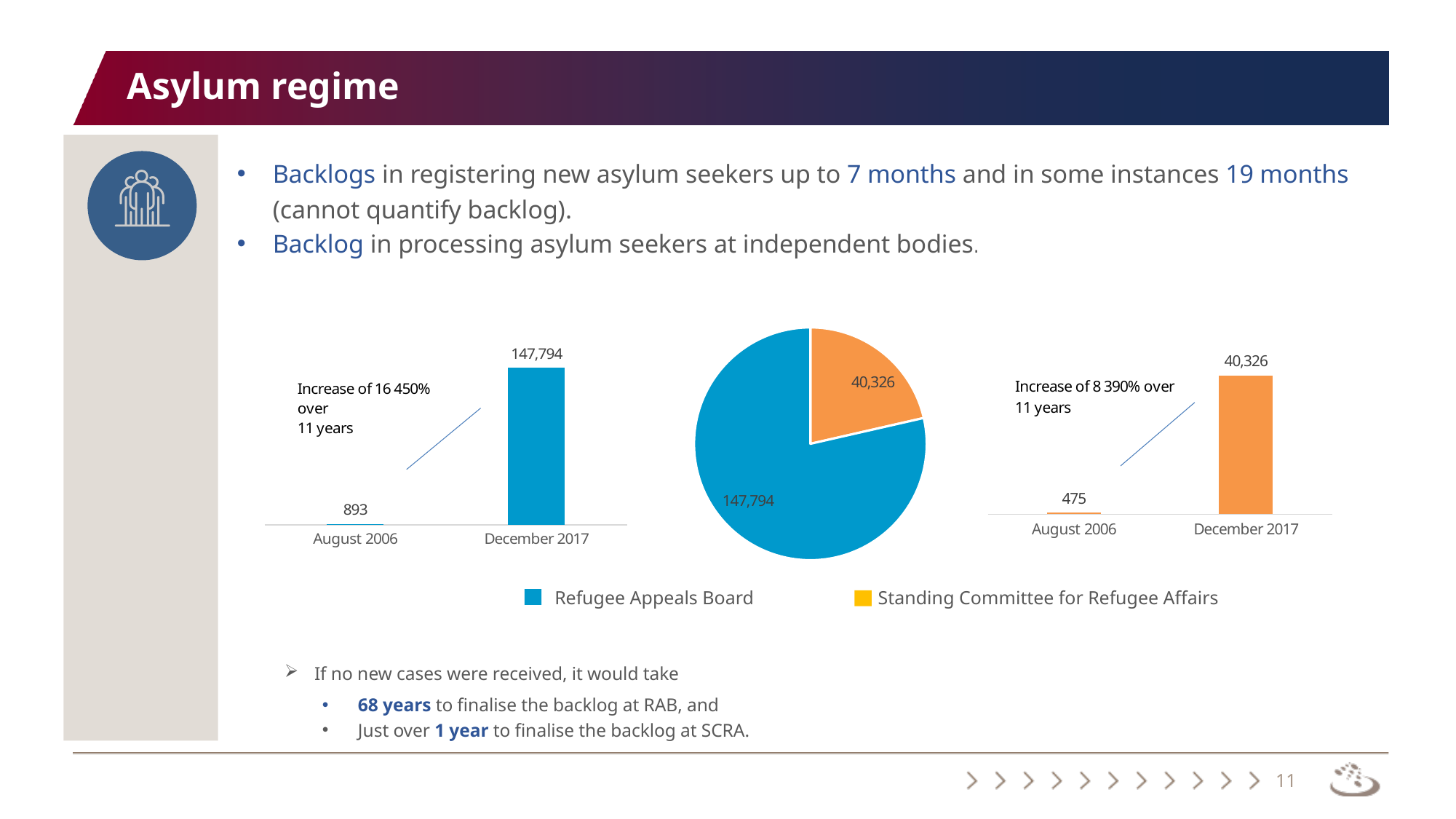
In the left bar chart, what is the difference between the December 2017 and August 2006 values? 146,901 In the middle pie chart, which slice is larger: Refugee Appeals Board or Standing Committee for Refugee Affairs? Refugee Appeals Board How many categories are shown on the x axis of the left bar chart? 2 In the right bar chart, what is the difference between the December 2017 and August 2006 values? 39,851 How many series does the legend below the charts list? 2 What is the total of the two slices in the middle pie chart? 188,120 In the right bar chart, what is the value for December 2017? 40,326 In the right bar chart, what is the value for August 2006? 475 In the middle pie chart, what is the value of the Standing Committee for Refugee Affairs slice? 40,326 What kind of chart is the middle chart on the slide? Pie chart In the left bar chart, what is the value for December 2017? 147,794 In the left bar chart, what is the value for August 2006? 893